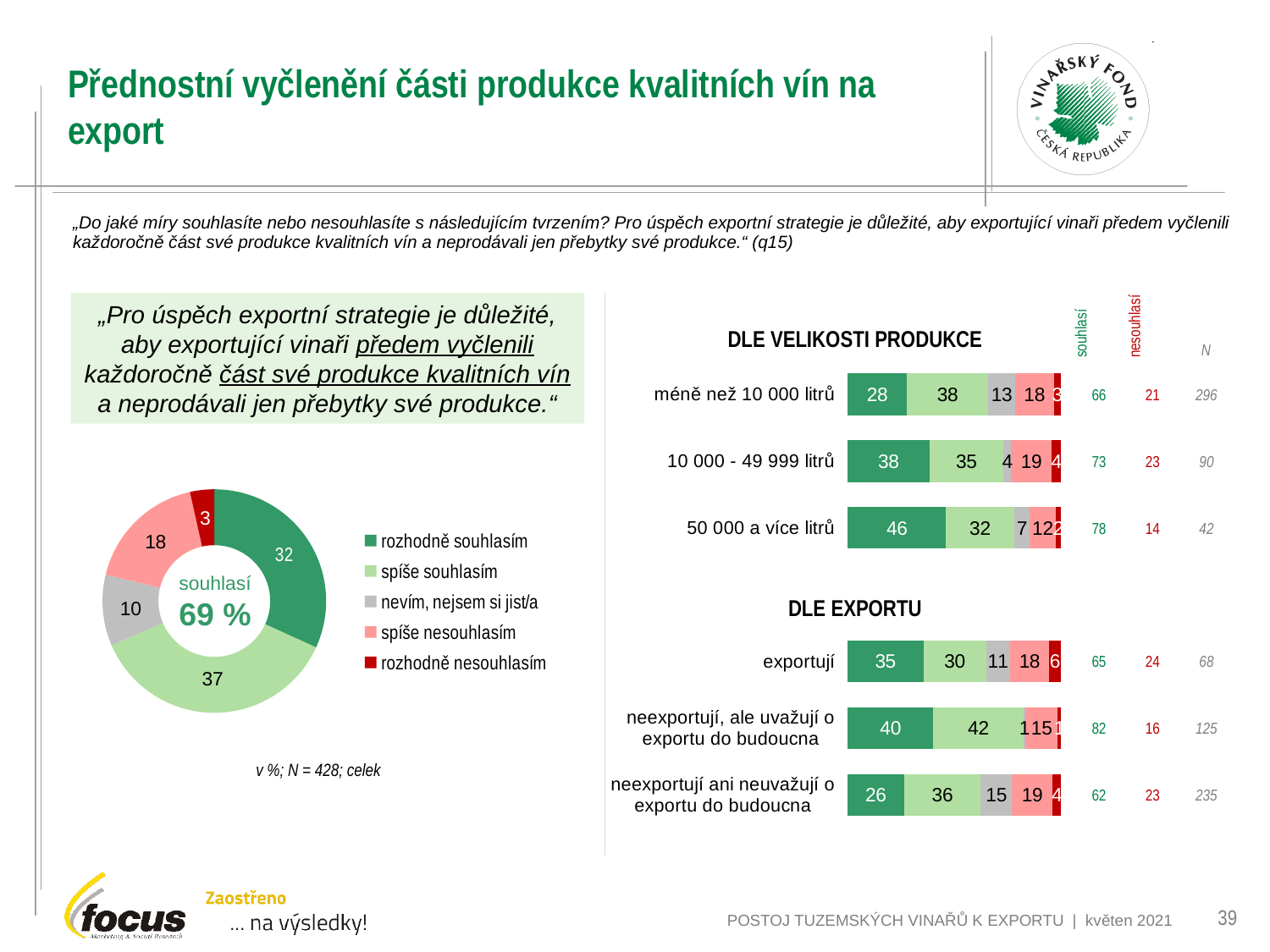
In the donut chart on the left, what percentage is shown for "rozhodně nesouhlasím"? 3 In the "DLE VELIKOSTI PRODUKCE" chart, what is the value of the first (dark green) segment for "50 000 a více litrů"? 46 In the donut chart on the left, which category has the smallest share? rozhodně nesouhlasím In the "DLE EXPORTU" chart, what is the value of the second (light green) segment for "neexportují, ale uvažují o exportu do budoucna"? 42 In the donut chart on the left, which category has the largest share? spíše souhlasím In the "DLE VELIKOSTI PRODUKCE" chart, what is the difference between the first (dark green) segment values for "10 000 - 49 999 litrů" and "méně než 10 000 litrů"? 10 In the "DLE VELIKOSTI PRODUKCE" chart, which category has the highest value in the first (dark green) segment? 50 000 a více litrů In the donut chart on the left, what is the combined share of "rozhodně souhlasím" and "spíše souhlasím" shown in the centre? 69 % What type of chart is used for "DLE EXPORTU"? stacked bar chart How many series does the legend of the donut chart on the left list? 5 In the donut chart on the left, what percentage is shown for "spíše souhlasím"? 37 In the "DLE EXPORTU" chart, which category has the lowest value in the first (dark green) segment? neexportují ani neuvažují o exportu do budoucna